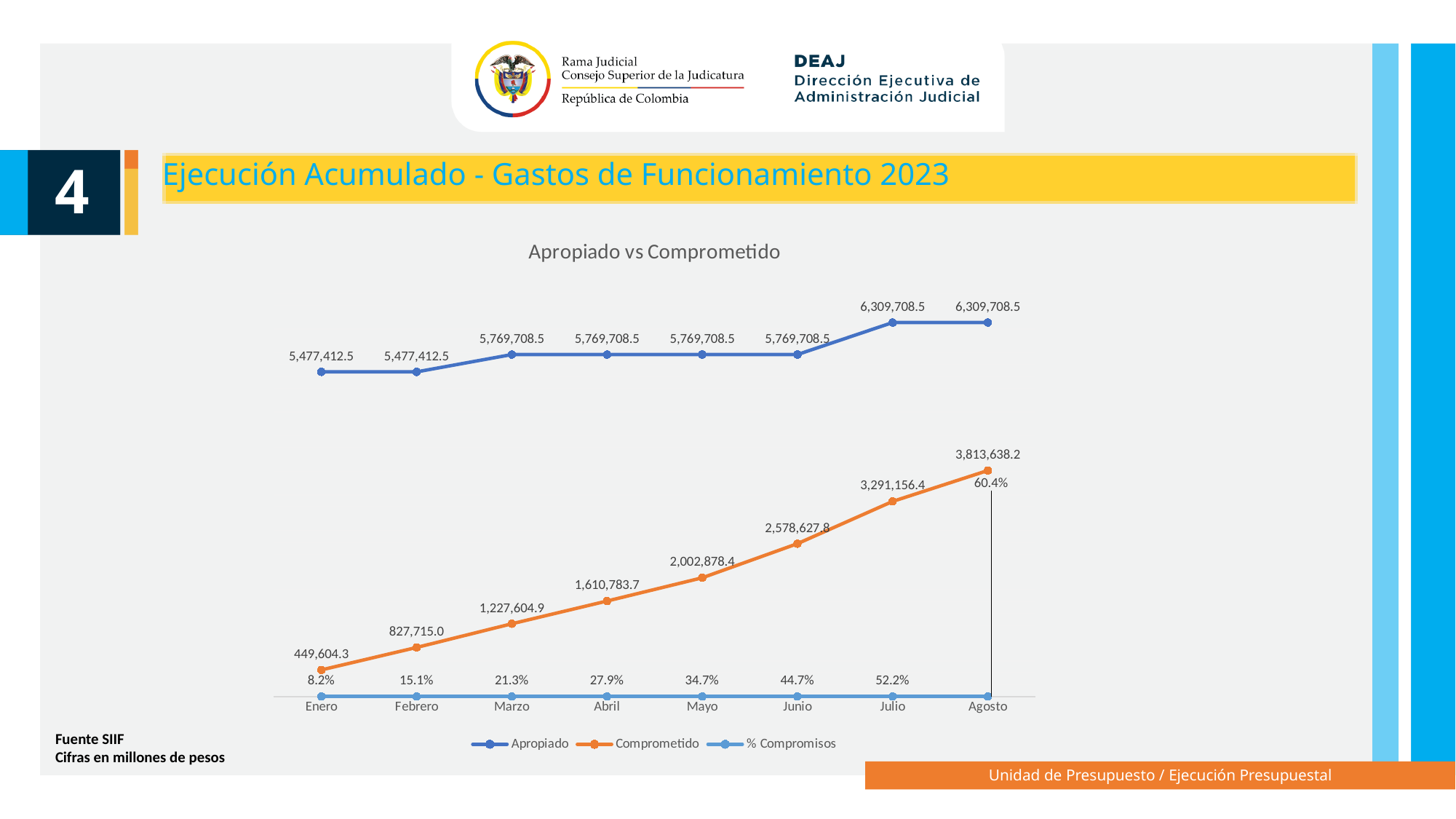
Does the Comprometido series rise or fall from Enero to Agosto? Rise How many series does the legend list? 3 In which month is the % Compromisos value highest? Agosto What is the difference between the Apropiado and Comprometido values in Agosto? 2,496,070.3 Which is larger, the Comprometido value for Marzo or for Abril? Abril What is the % Compromisos value for Junio? 44.7% How many months are shown on the x axis? 8 What is the title of the chart? Apropiado vs Comprometido What type of chart is shown on the slide? Line chart What is the Apropiado value for Julio? 6,309,708.5 What is the Comprometido value for Mayo? 2,002,878.4 In which month is the Comprometido value lowest? Enero